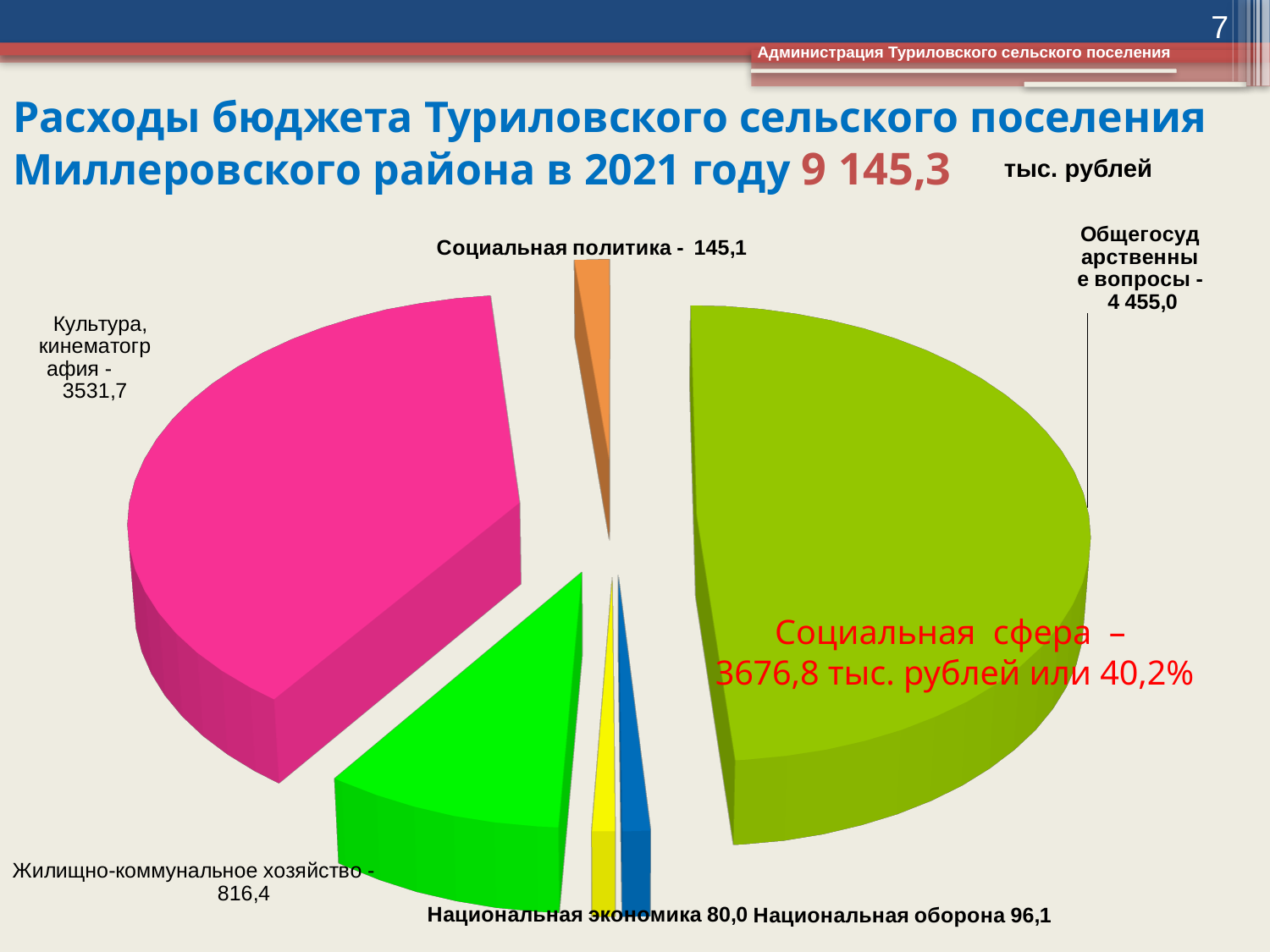
What is the value for Национальная оборона? 96,1 Which is larger, Жилищно-коммунальное хозяйство or Социальная политика? Жилищно-коммунальное хозяйство What is the value for Жилищно-коммунальное хозяйство? 816,4 What total budget expenditure figure is shown in the slide title? 9 145,3 What is the value for Культура, кинематография? 3531,7 What is the difference between Национальная оборона and Национальная экономика? 16,1 What kind of chart is shown on the slide? pie chart Which category has the smallest slice of the pie? Национальная экономика What is the value for Социальная политика? 145,1 Which category has the largest slice of the pie? Общегосударственные вопросы What is the value for Общегосударственные вопросы? 4 455,0 How many slices does the pie chart have? 6